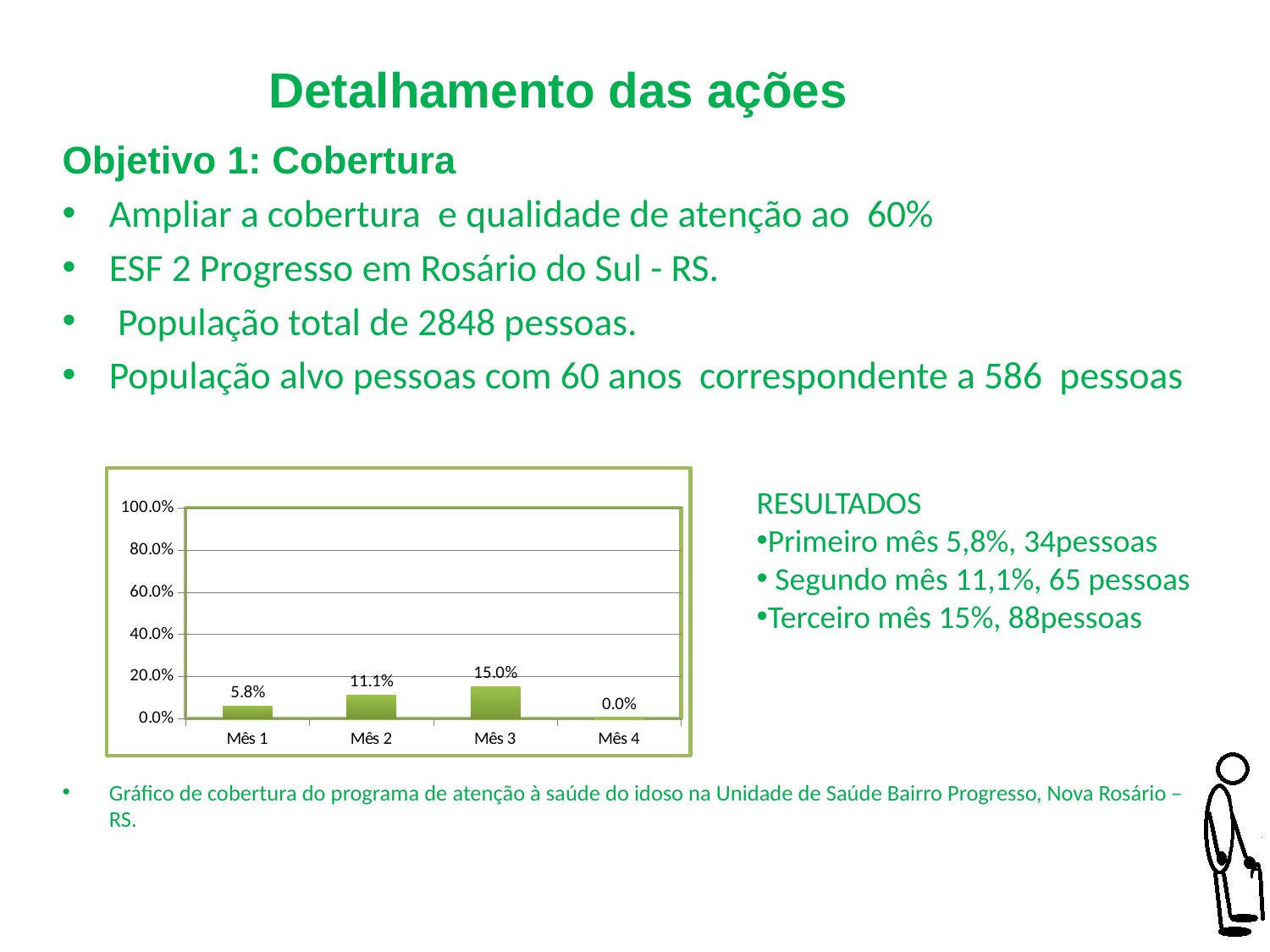
What is the difference between the values for Mês 3 and Mês 1? 9.2% What is the value for Mês 2? 11.1% Which month has the lowest value? Mês 4 Do the values rise or fall from Mês 1 to Mês 3? rise What is the value for Mês 3? 15.0% Is the value for Mês 3 greater or less than 20.0%? less Which month has the highest value? Mês 3 What kind of chart is shown? bar chart What is the value for Mês 4? 0.0% Which is larger, the value for Mês 2 or the value for Mês 1? Mês 2 What is the value for Mês 1? 5.8% How many months are shown on the x axis? 4